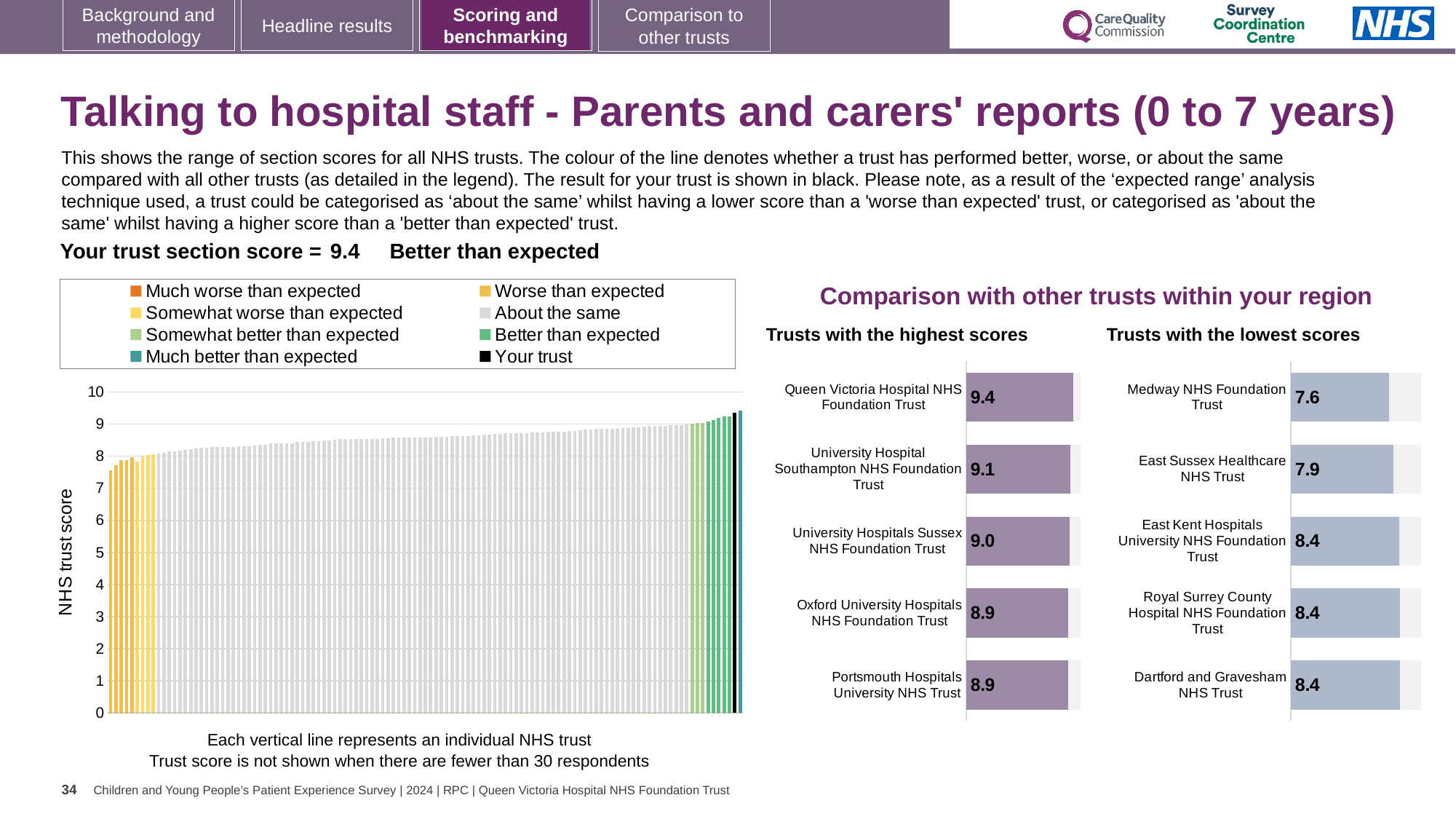
In the 'Trusts with the lowest scores' chart, what is the score for Medway NHS Foundation Trust? 7.6 What is the difference between the score of Queen Victoria Hospital NHS Foundation Trust in the highest scores chart and Medway NHS Foundation Trust in the lowest scores chart? 1.8 What kind of chart is the large chart on the left showing all NHS trust scores? Bar chart What is the y-axis label of the large chart on the left? NHS trust score In the 'Trusts with the highest scores' chart, what is the difference between the scores of University Hospital Southampton NHS Foundation Trust and Oxford University Hospitals NHS Foundation Trust? 0.2 In the 'Trusts with the highest scores' chart, which trust has the highest score? Queen Victoria Hospital NHS Foundation Trust In the 'Trusts with the lowest scores' chart, which trust has the lowest score? Medway NHS Foundation Trust In the 'Trusts with the highest scores' chart, what is the score for University Hospital Southampton NHS Foundation Trust? 9.1 How many entries does the legend above the large chart on the left list? 8 How many trusts are shown in the 'Trusts with the highest scores' chart? 5 Which has the larger score: University Hospitals Sussex NHS Foundation Trust in the highest scores chart or East Sussex Healthcare NHS Trust in the lowest scores chart? University Hospitals Sussex NHS Foundation Trust In the 'Trusts with the highest scores' chart, what is the score for Queen Victoria Hospital NHS Foundation Trust? 9.4